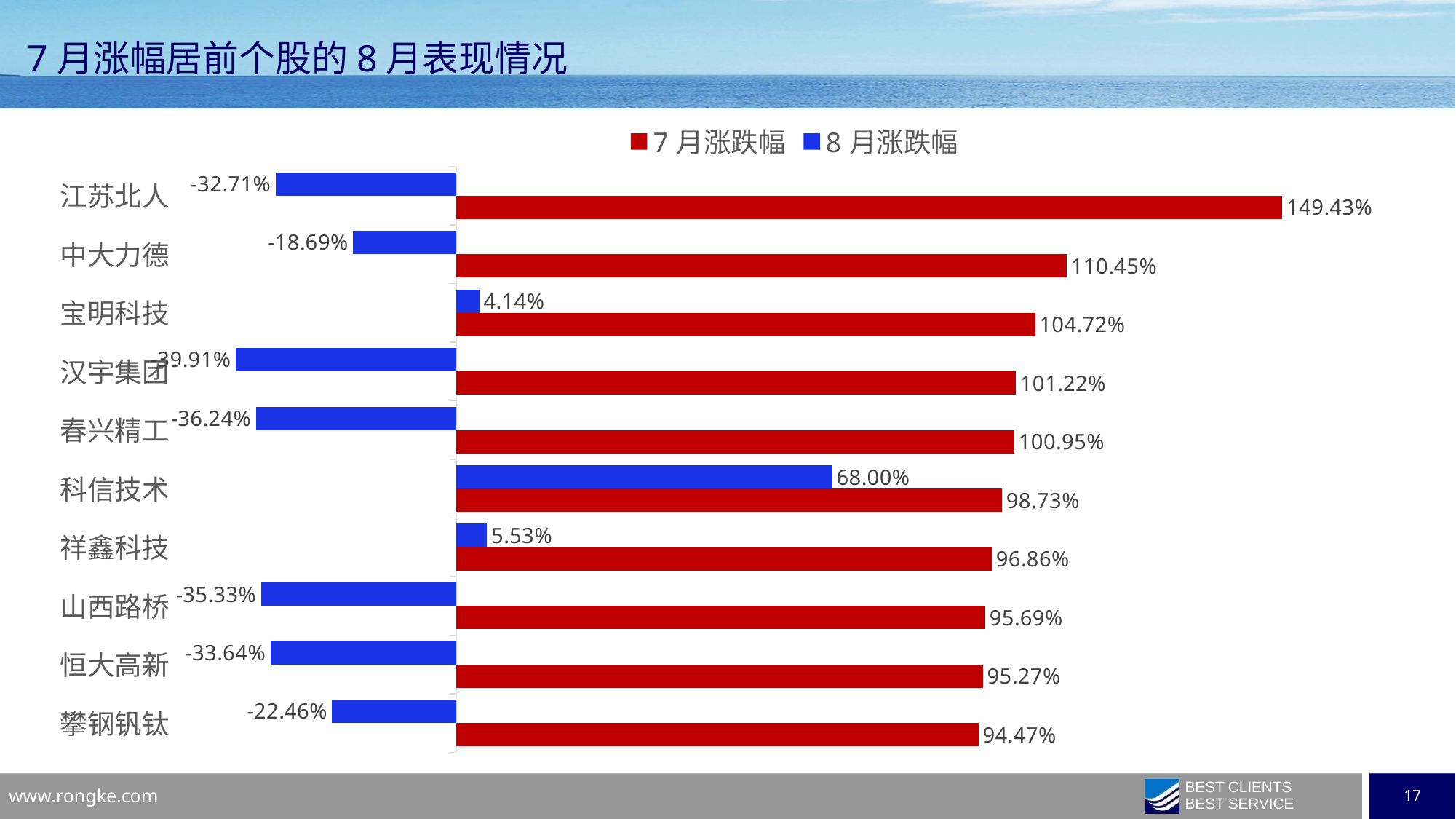
How many series does the legend list? 2 For 科信技术, how much higher is the 7月涨跌幅 than the 8月涨跌幅? 30.73% What is the 8月涨跌幅 value for 科信技术? 68.00% Which has the larger 8月涨跌幅, 宝明科技 or 祥鑫科技? 祥鑫科技 How many stocks are shown in the chart? 10 Which stock has the highest 7月涨跌幅? 江苏北人 Which stock has the highest 8月涨跌幅? 科信技术 What is the 7月涨跌幅 value for 江苏北人? 149.43% What kind of chart is shown on the slide? Bar chart What is the difference between the 7月涨跌幅 of 江苏北人 and 中大力德? 38.98% Which stock has the lowest 7月涨跌幅? 攀钢钒钛 What is the 8月涨跌幅 value for 攀钢钒钛? -22.46%